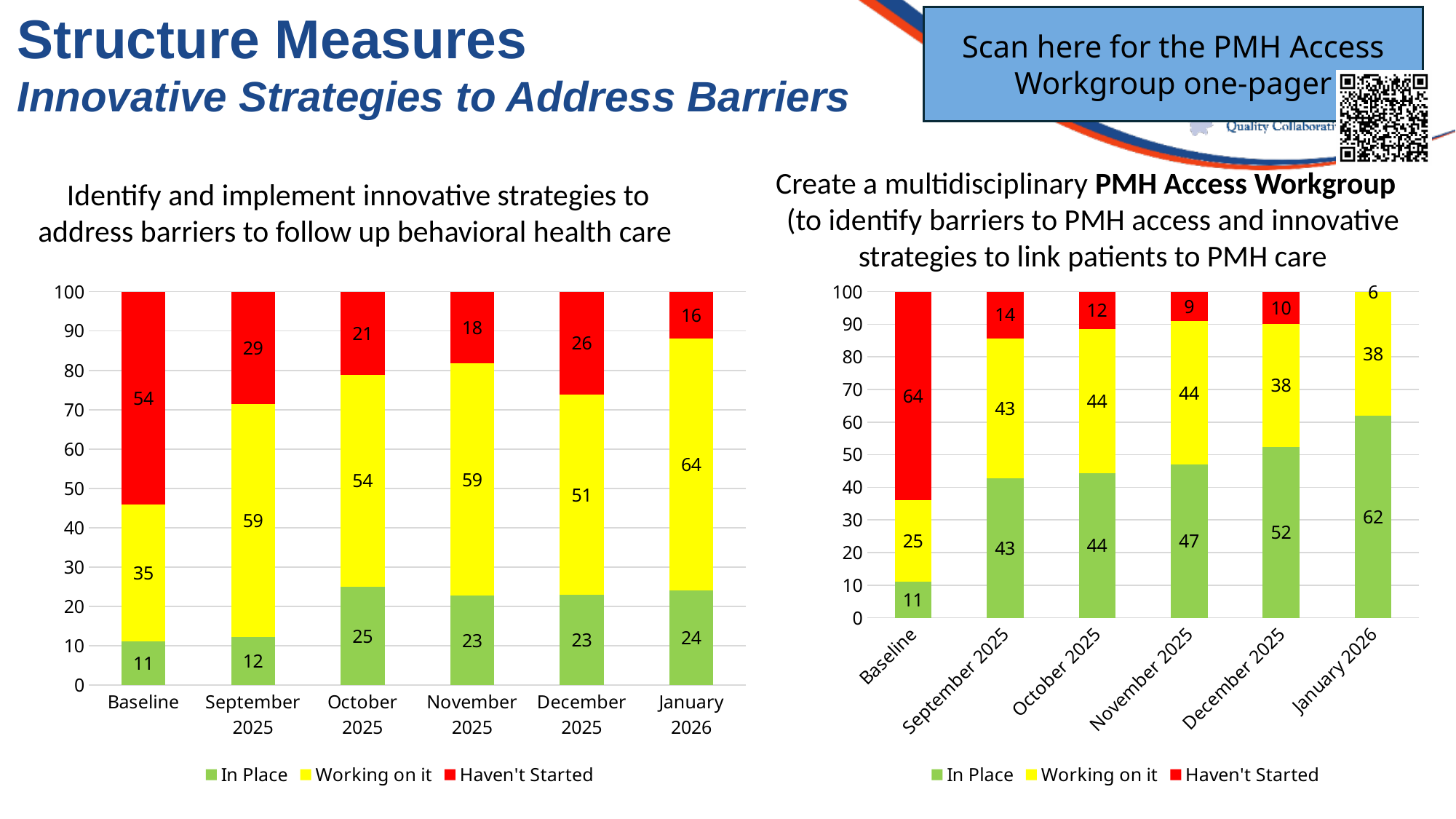
In the left chart (innovative strategies to address barriers), what is the 'Working on it' value for January 2026? 64 How many periods are shown on the x axis of the left chart (innovative strategies to address barriers)? 6 In the right chart (PMH Access Workgroup), which period has the highest 'In Place' value? January 2026 In the right chart (PMH Access Workgroup), what is the 'Haven't Started' value for November 2025? 9 In the right chart (PMH Access Workgroup), what is the 'In Place' value for December 2025? 52 In the left chart (innovative strategies to address barriers), what is the 'Haven't Started' value for Baseline? 54 How many series does the legend of the right chart (PMH Access Workgroup) list? 3 What kind of chart is the right chart (PMH Access Workgroup)? Stacked bar chart In the right chart (PMH Access Workgroup), what is the difference between the 'Haven't Started' value at Baseline and in September 2025? 50 In the left chart (innovative strategies to address barriers), is the 'In Place' value larger for October 2025 or for September 2025? October 2025 In the left chart (innovative strategies to address barriers), which period has the lowest 'Haven't Started' value? January 2026 In the right chart (PMH Access Workgroup), does the 'In Place' value rise or fall from Baseline to January 2026? Rise